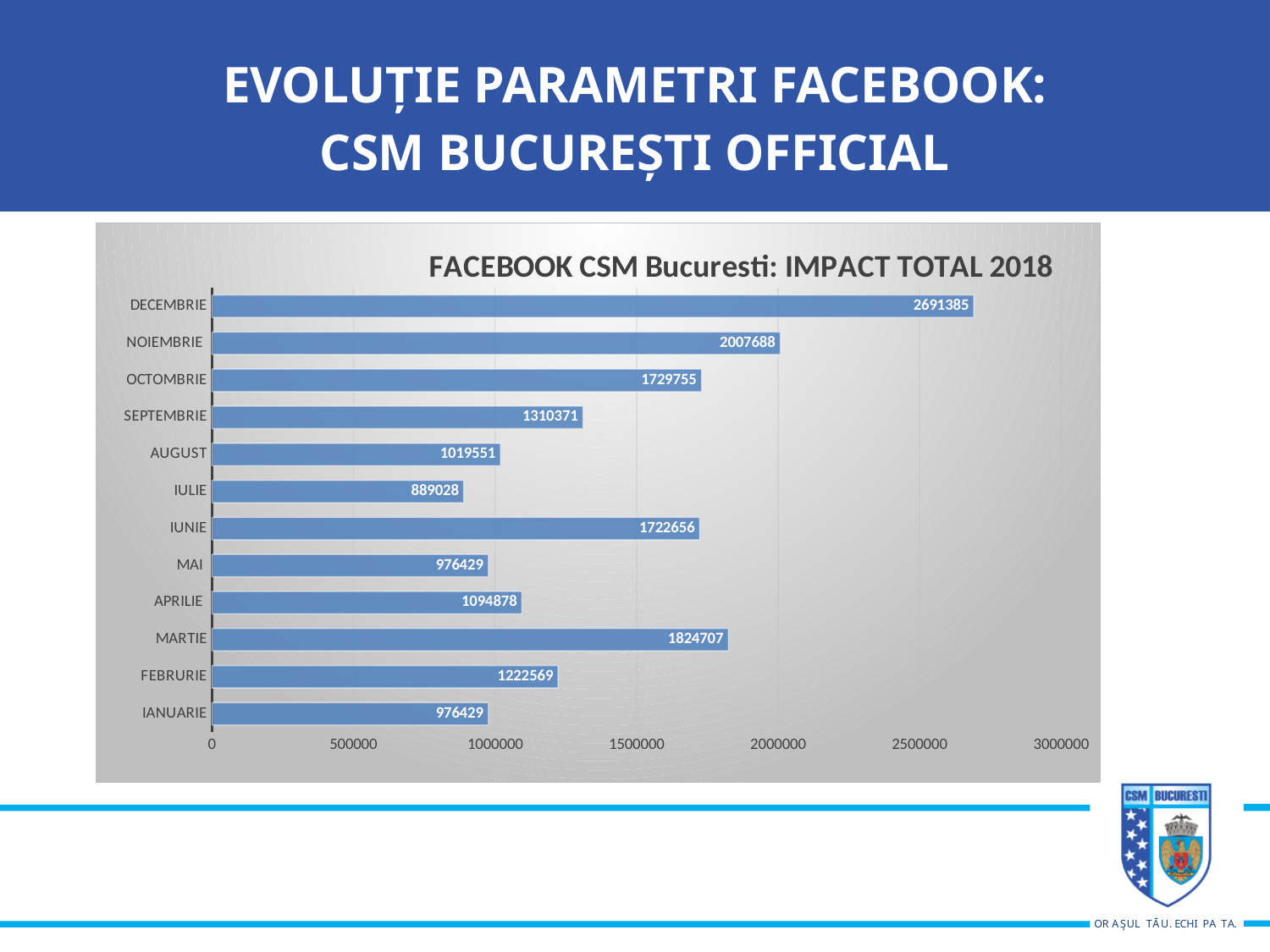
Which month has the lowest value? IULIE Is the value for SEPTEMBRIE greater or less than 1000000? greater What is the value for DECEMBRIE? 2691385 What is the value for FEBRURIE? 1222569 Which is larger, the value for NOIEMBRIE or the value for MARTIE? NOIEMBRIE What is the value for IUNIE? 1722656 What type of chart is shown on the slide? bar chart What is the difference between the values for DECEMBRIE and NOIEMBRIE? 683697 What is the difference between the values for MARTIE and FEBRURIE? 602138 Which month has the highest value? DECEMBRIE What is the title of the chart? FACEBOOK CSM Bucuresti: IMPACT TOTAL 2018 How many months (categories) are plotted in the chart? 12